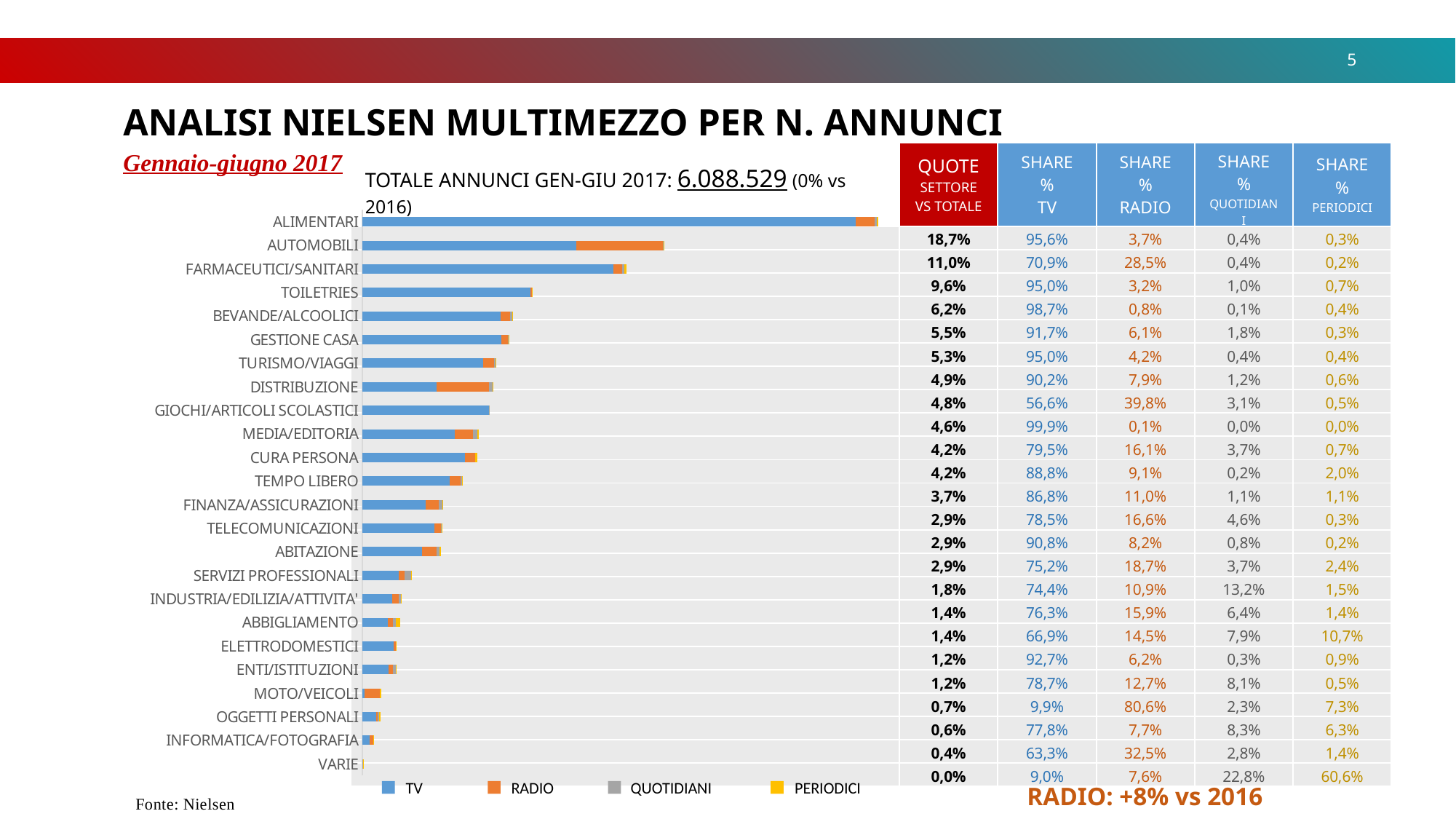
What are the series listed in the chart legend? TV, RADIO, QUOTIDIANI, PERIODICI What kind of chart is shown on the slide? Stacked bar chart According to the QUOTE SETTORE VS TOTALE column next to the chart, what is the share for ALIMENTARI? 18,7% Which sector has the shortest bar in the chart? VARIE Which bar is longer, AUTOMOBILI or TOILETRIES? AUTOMOBILI Do the bar lengths rise or fall going from the top category to the bottom category? Fall What is the total number of annunci for GEN-GIU 2017 stated above the chart? 6.088.529 How many series does the chart legend list? 4 How many sector categories are plotted in the chart? 24 According to the SHARE % TV column next to the chart, what is the TV share for AUTOMOBILI? 70,9% Which sector has the longest bar in the chart? ALIMENTARI Which sector has the larger RADIO segment, AUTOMOBILI or FARMACEUTICI/SANITARI? AUTOMOBILI